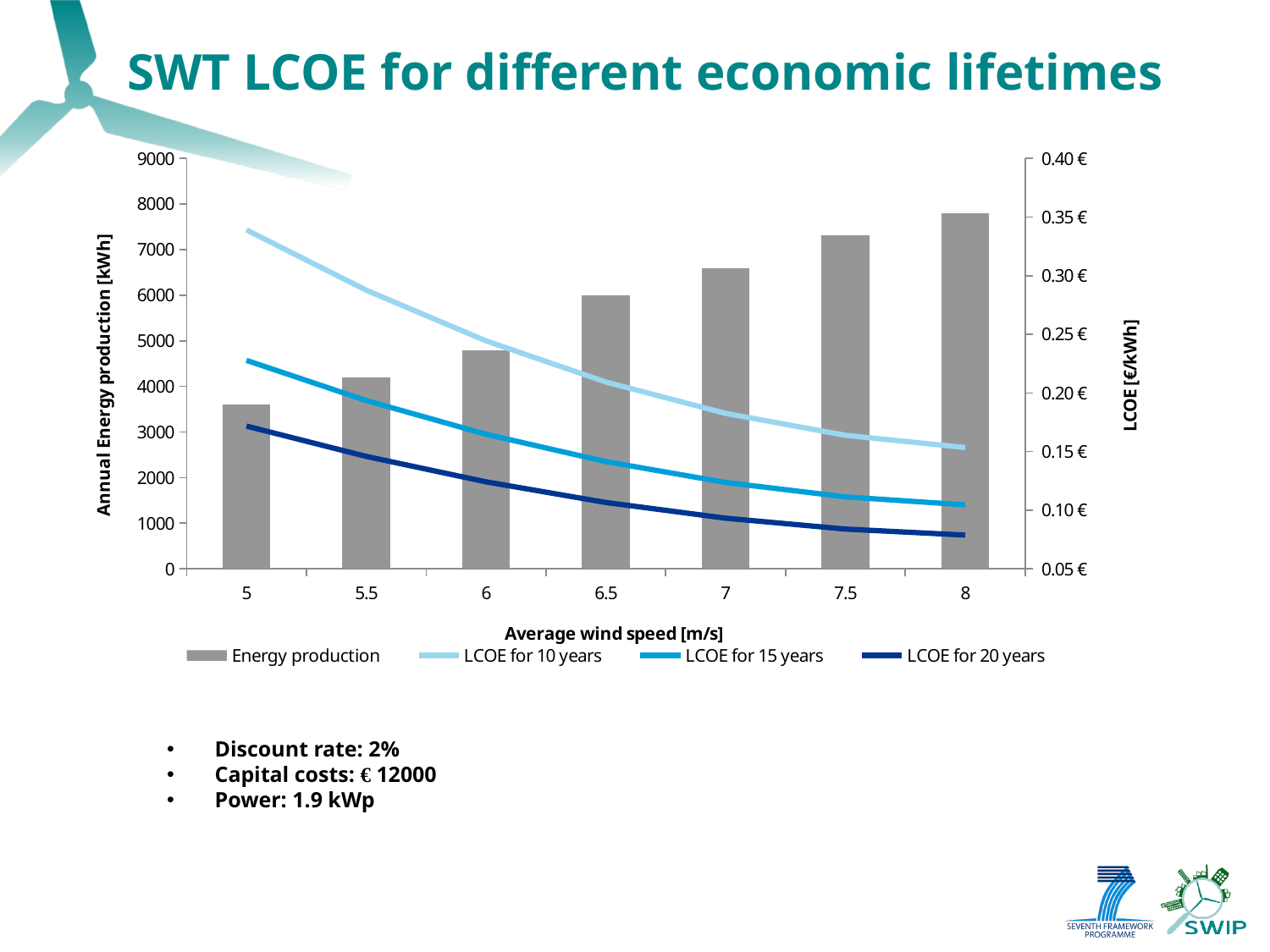
What kind of chart is shown on the slide? A combination bar and line chart Does the annual energy production rise or fall as the average wind speed increases? Rise At which average wind speed is the annual energy production highest? 8 m/s How many average wind speed categories are shown on the x axis? 7 What is the title of the slide containing the chart? SWT LCOE for different economic lifetimes How many series does the legend list? 4 At which average wind speed is the annual energy production lowest? 5 m/s Does the LCOE for 10 years rise or fall as the average wind speed increases? Fall Is the LCOE for 10 years at 5 m/s greater or less than 0.30 €? greater Is the annual energy production at 5 m/s greater or less than 4000 kWh? less At 5 m/s, which is higher: the LCOE for 10 years or the LCOE for 20 years? LCOE for 10 years Is the annual energy production at 8 m/s greater or less than 7000 kWh? greater